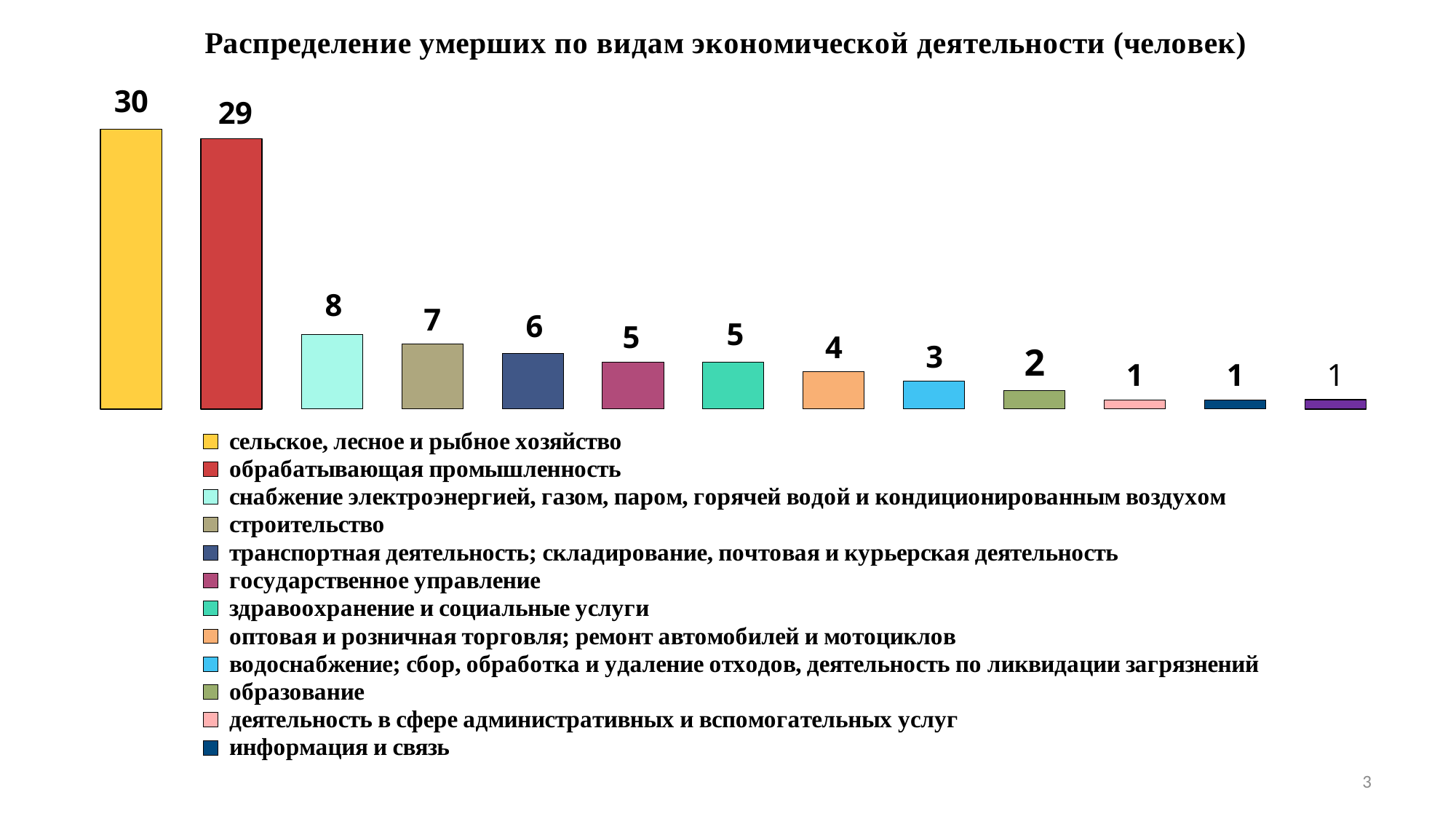
Which is larger: the value for государственное управление or the value for водоснабжение; сбор, обработка и удаление отходов, деятельность по ликвидации загрязнений? государственное управление What is the difference between the values for снабжение электроэнергией, газом, паром, горячей водой и кондиционированным воздухом and оптовая и розничная торговля; ремонт автомобилей и мотоциклов? 4 How many bars are plotted in the chart? 13 What is the value for здравоохранение и социальные услуги? 5 Which category has the highest value? сельское, лесное и рыбное хозяйство What is the value for сельское, лесное и рыбное хозяйство? 30 What kind of chart is shown on the slide? bar chart What is the title of the chart? Распределение умерших по видам экономической деятельности (человек) What is the difference between the values for сельское, лесное и рыбное хозяйство and обрабатывающая промышленность? 1 What is the value for образование? 2 What is the value for обрабатывающая промышленность? 29 What is the value for строительство? 7